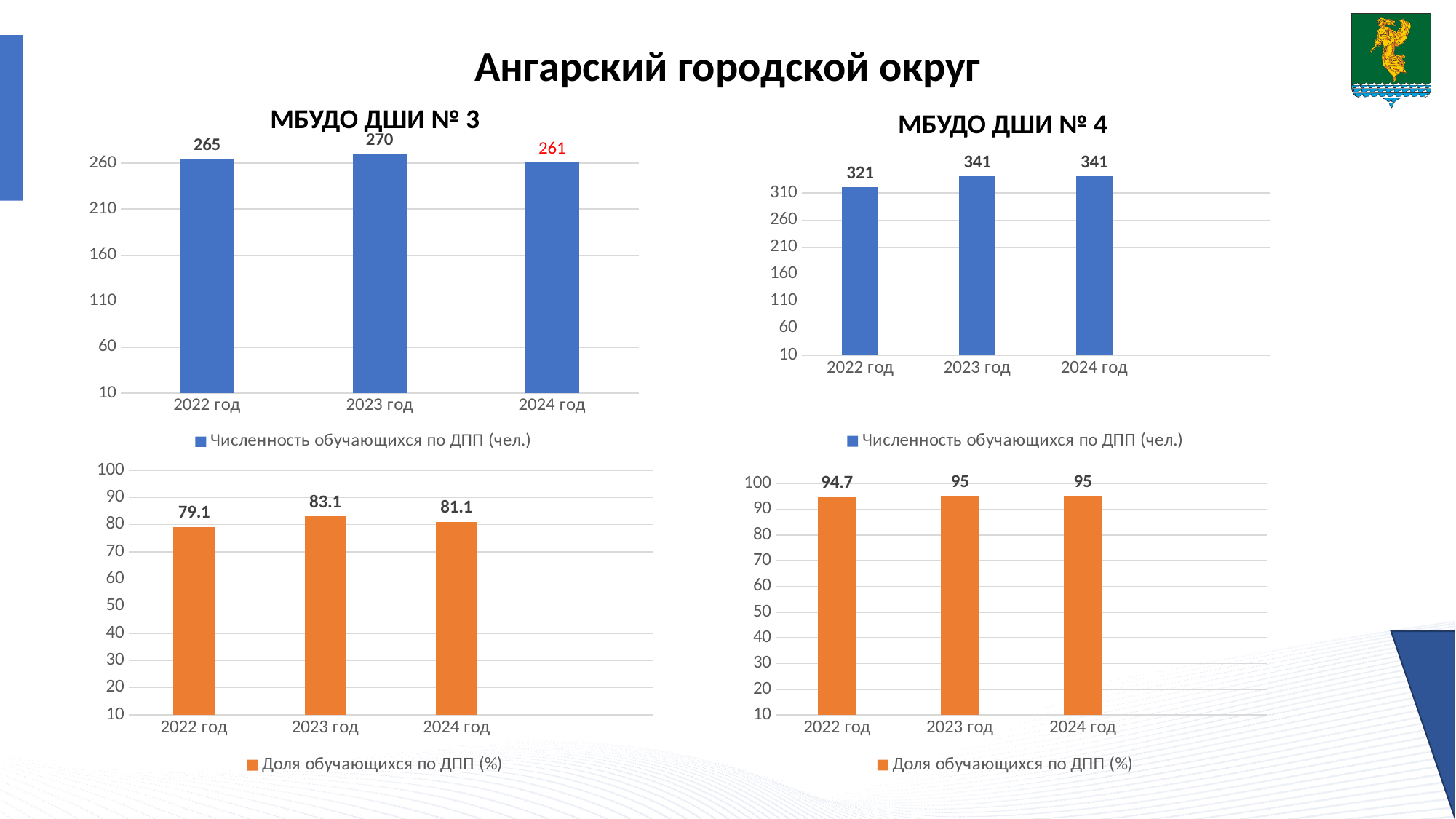
In the bottom-right chart (МБУДО ДШИ № 4, Доля обучающихся по ДПП), what is the value for 2022 год? 94.7 In the top-left chart (МБУДО ДШИ № 3, Численность обучающихся по ДПП), what is the difference between the 2023 год and 2024 год values? 9 In the bottom-left chart (МБУДО ДШИ № 3, Доля обучающихся по ДПП), which year has the highest value? 2023 год What is the legend entry of the bottom-left chart (МБУДО ДШИ № 3)? Доля обучающихся по ДПП (%) In the top-left chart (МБУДО ДШИ № 3, Численность обучающихся по ДПП), which year has the lowest value? 2024 год In the top-right chart (МБУДО ДШИ № 4, Численность обучающихся по ДПП), what is the difference between the 2023 год and 2022 год values? 20 In the bottom-right chart (МБУДО ДШИ № 4, Доля обучающихся по ДПП), is the value for 2023 год larger or smaller than the value for 2022 год? larger How many categories (years) are shown in the top-left chart (МБУДО ДШИ № 3, Численность обучающихся по ДПП)? 3 What kind of chart is the bottom-right chart (МБУДО ДШИ № 4, Доля обучающихся по ДПП)? bar chart In the bottom-left chart (МБУДО ДШИ № 3, Доля обучающихся по ДПП), what is the value for 2022 год? 79.1 In the top-right chart (МБУДО ДШИ № 4, Численность обучающихся по ДПП), what is the value for 2022 год? 321 In the top-left chart (МБУДО ДШИ № 3, Численность обучающихся по ДПП), what is the value for 2023 год? 270